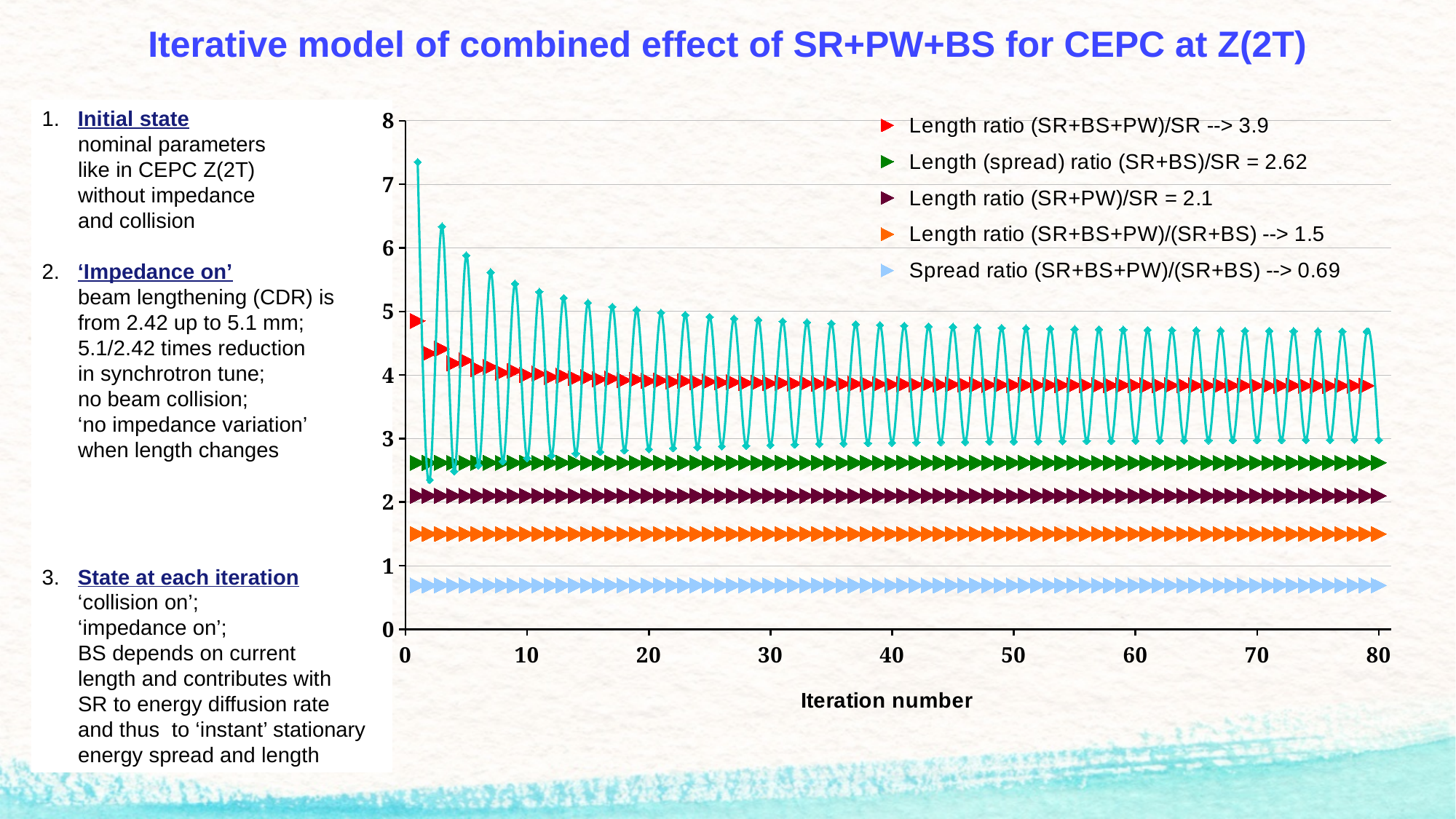
Is the value of the Length (spread) ratio (SR+BS)/SR series greater or less than 2? greater According to the legend, what value does the Length (spread) ratio (SR+BS)/SR equal? 2.62 Which legend series has the lowest values on the chart? Spread ratio (SR+BS+PW)/(SR+BS) --> 0.69 Does the Length ratio (SR+BS+PW)/SR series rise or fall as the iteration number increases? fall What type of chart is shown on the slide? line chart What is the label of the x axis of the chart? Iteration number According to the legend, what value does the Length ratio (SR+PW)/SR equal? 2.1 Which legend series has the highest values on the chart? Length ratio (SR+BS+PW)/SR --> 3.9 According to the legend, what value does the Length ratio (SR+BS+PW)/SR tend to? 3.9 Is the value of the Length ratio (SR+BS+PW)/(SR+BS) series greater or less than 2? less According to the legend, what value does the Spread ratio (SR+BS+PW)/(SR+BS) tend to? 0.69 How many series does the chart legend list? 5